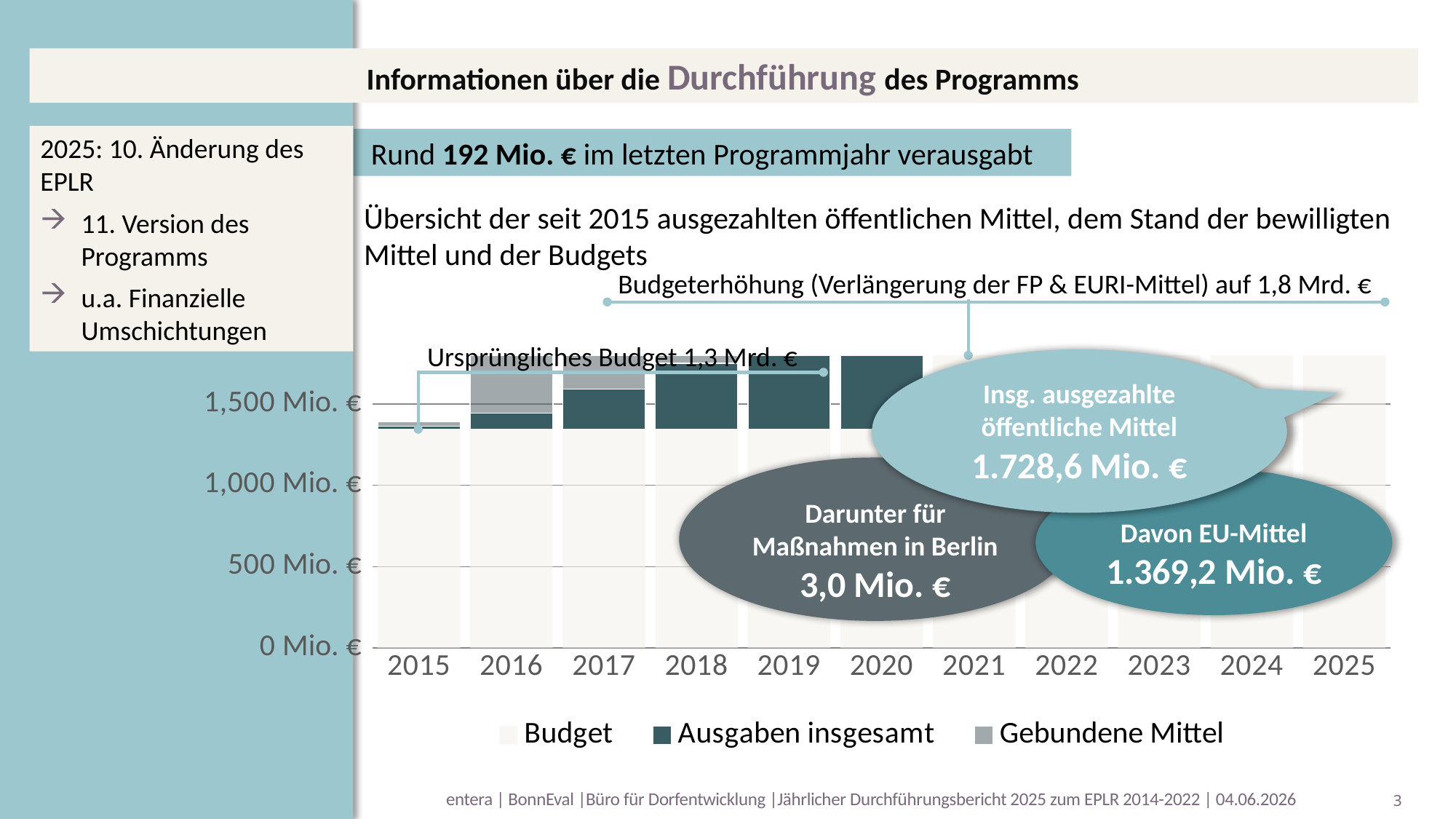
How many years are shown on the x axis of the chart? 11 What kind of chart is shown on the slide? bar chart Which series are listed in the chart legend? Budget, Ausgaben insgesamt, Gebundene Mittel How many series does the chart legend list? 3 What is the first year shown on the x axis of the chart? 2015 Do the Ausgaben insgesamt bars rise or fall from 2015 to 2020? rise